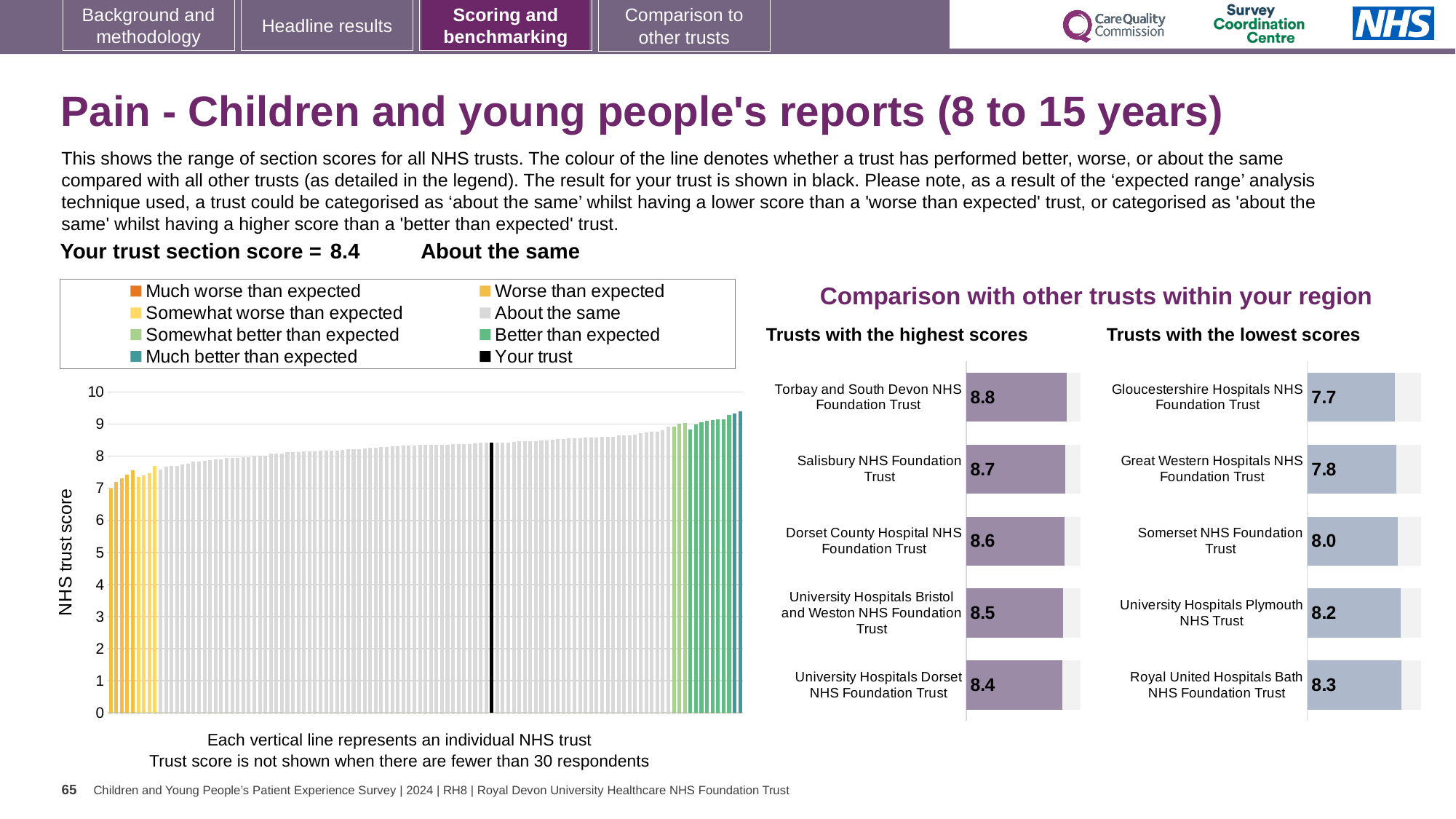
How many trusts are shown in the 'Trusts with the highest scores' chart? 5 In the 'Trusts with the lowest scores' chart, which has the higher score: Somerset NHS Foundation Trust or University Hospitals Plymouth NHS Trust? University Hospitals Plymouth NHS Trust In the 'Trusts with the highest scores' chart, what is the score for Dorset County Hospital NHS Foundation Trust? 8.6 In the 'Trusts with the highest scores' chart, what is the score for Torbay and South Devon NHS Foundation Trust? 8.8 In the 'Trusts with the lowest scores' chart, which trust has the highest score? Royal United Hospitals Bath NHS Foundation Trust In the 'Trusts with the highest scores' chart, what is the difference between the scores of Torbay and South Devon NHS Foundation Trust and University Hospitals Dorset NHS Foundation Trust? 0.4 What type of chart is the large chart on the left showing all NHS trusts? Bar chart In the 'Trusts with the lowest scores' chart, what is the difference between the scores of Royal United Hospitals Bath NHS Foundation Trust and Gloucestershire Hospitals NHS Foundation Trust? 0.6 In the large chart on the left showing all NHS trusts, is the value of the black bar for your trust greater or less than 8? greater In the 'Trusts with the highest scores' chart, which trust has the lowest score? University Hospitals Dorset NHS Foundation Trust In the 'Trusts with the lowest scores' chart, what is the score for Gloucestershire Hospitals NHS Foundation Trust? 7.7 In the 'Trusts with the lowest scores' chart, what is the score for University Hospitals Plymouth NHS Trust? 8.2